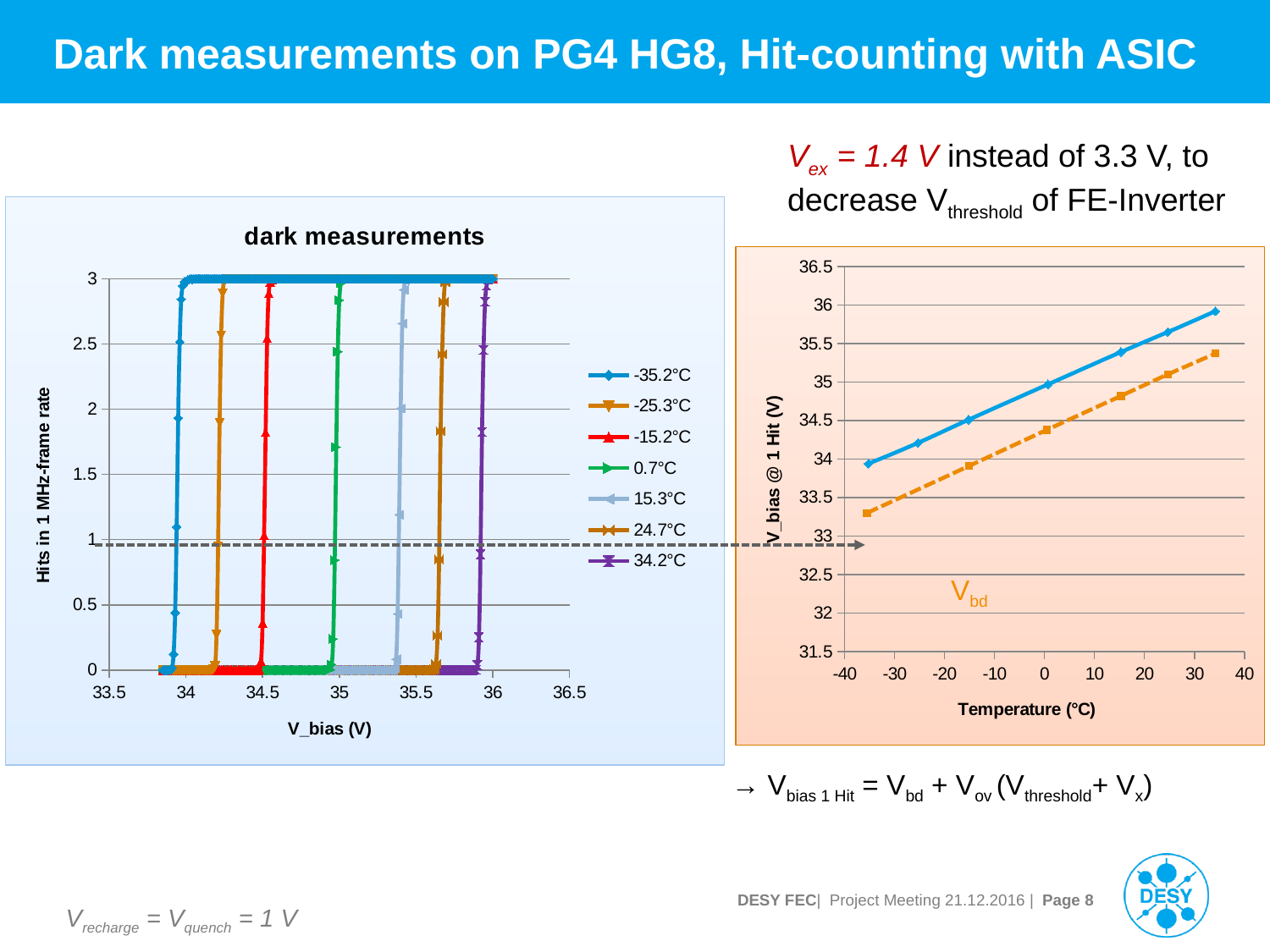
In the 'dark measurements' chart on the left, which temperature series reaches 3 hits at the lowest V_bias? -35.2°C In the right-hand chart of V_bias @ 1 Hit versus Temperature, does the blue solid line rise or fall as temperature increases? rise In the right-hand chart of V_bias @ 1 Hit versus Temperature, which line is higher at every temperature, the blue solid line or the orange dashed V_bd line? the blue solid line What kind of chart is the 'dark measurements' chart on the left? line chart In the 'dark measurements' chart on the left, which temperature series reaches 3 hits at the highest V_bias? 34.2°C In the 'dark measurements' chart on the left, what is the label of the x axis? V_bias (V) In the right-hand chart of V_bias @ 1 Hit versus Temperature, how many series are plotted? 2 In the right-hand chart of V_bias @ 1 Hit versus Temperature, is the blue solid line's value at 0 °C greater or less than 34.5? greater In the right-hand chart of V_bias @ 1 Hit versus Temperature, is the orange dashed V_bd line's value at 0 °C greater or less than 34.5? less In the 'dark measurements' chart on the left, how many series does the legend list? 7 What is the title of the chart on the left of the slide? dark measurements In the 'dark measurements' chart on the left, do the hit rates rise or fall as V_bias increases? rise